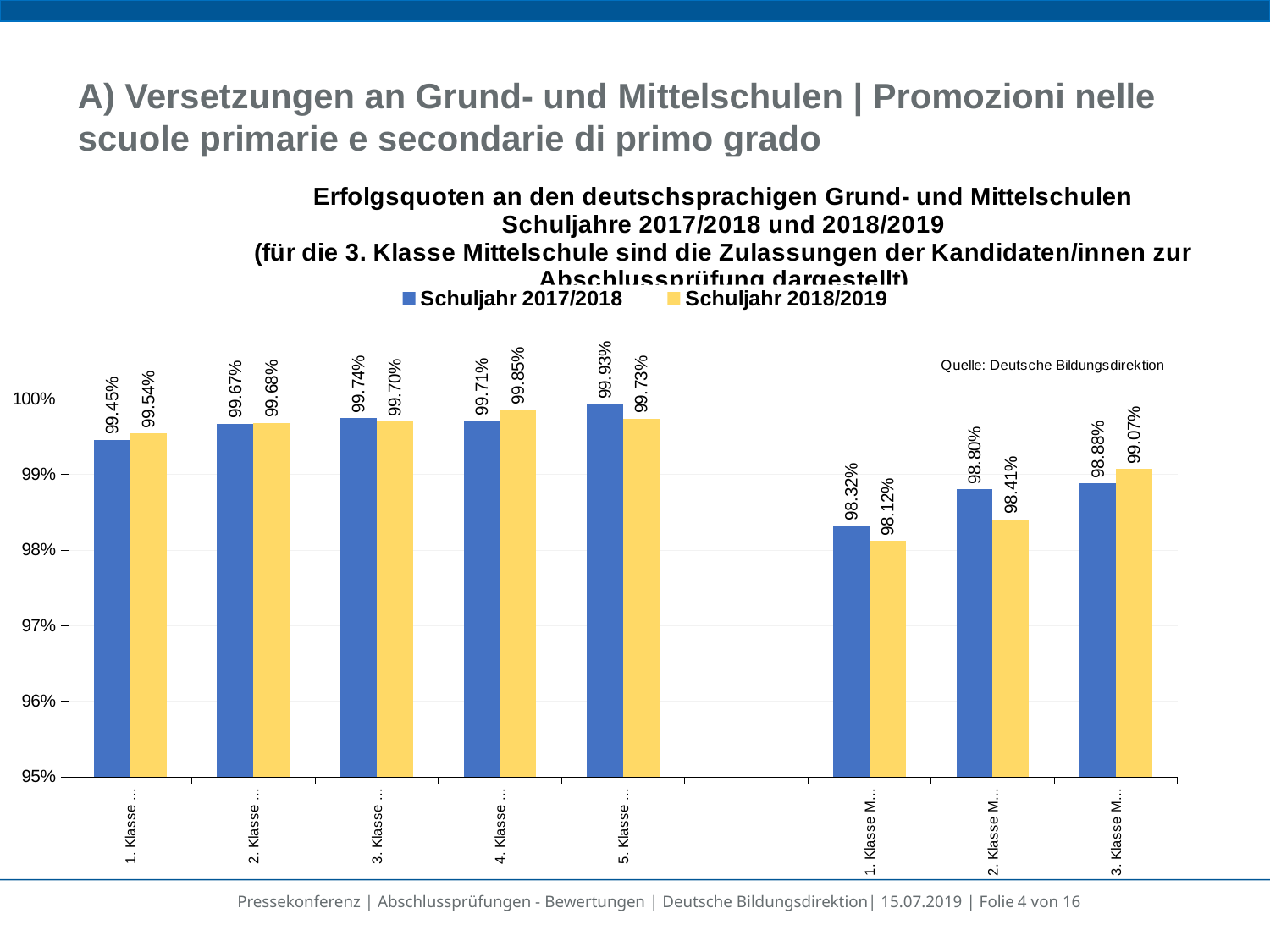
What source is cited for the chart data? Deutsche Bildungsdirektion In the 5. Klasse category, which series has the larger value, Schuljahr 2017/2018 or Schuljahr 2018/2019? Schuljahr 2017/2018 How many categories (classes) are shown on the x axis of the chart? 8 What is the difference between the Schuljahr 2017/2018 and Schuljahr 2018/2019 values in the 2. Klasse M... category? 0.39 percentage points Which category has the lowest value for Schuljahr 2018/2019? 1. Klasse M... What is the value for Schuljahr 2017/2018 in the 5. Klasse category? 99.93% What is the value for Schuljahr 2018/2019 in the 1. Klasse M... category? 98.12% Is the Schuljahr 2017/2018 value for 1. Klasse M... greater or less than 99%? less What is the value for Schuljahr 2018/2019 in the 4. Klasse category? 99.85% How many series does the chart legend list? 2 What kind of chart is shown on the slide? Bar chart Which category has the highest value for Schuljahr 2017/2018? 5. Klasse